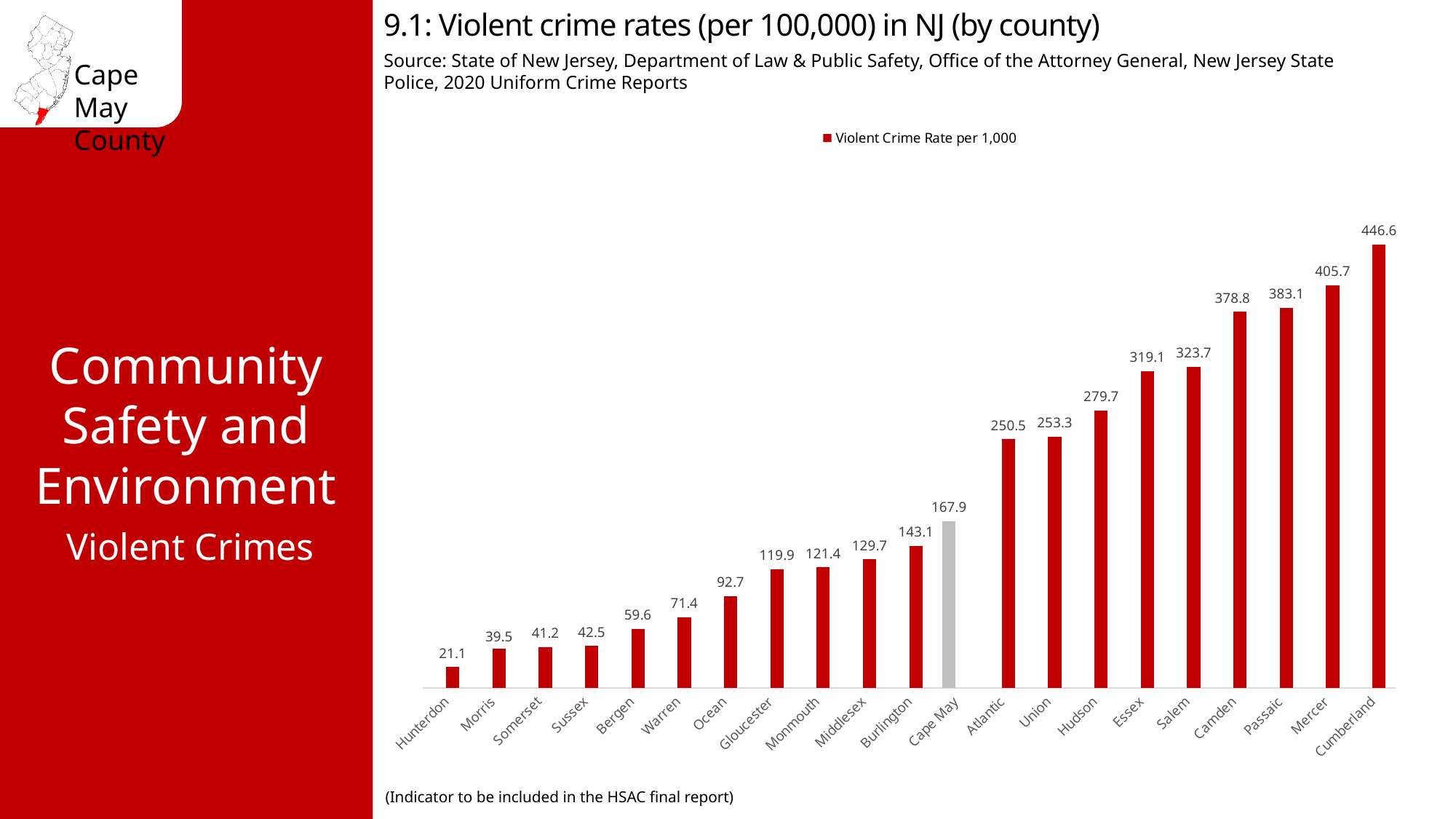
What is the violent crime rate shown for Ocean? 92.7 What is the difference between the violent crime rates of Cumberland and Hunterdon? 425.5 What is the violent crime rate shown for Cape May? 167.9 What is the difference between the violent crime rates of Cape May and Burlington? 24.8 What kind of chart is shown on the slide? Bar chart Which county has a higher violent crime rate, Essex or Atlantic? Essex What is the violent crime rate shown for Hudson? 279.7 How many series does the legend list? 1 Do the values rise or fall moving from left to right along the x axis? Rise Which county has the lowest violent crime rate on the chart? Hunterdon Which county has the highest violent crime rate on the chart? Cumberland How many counties are shown on the chart? 21